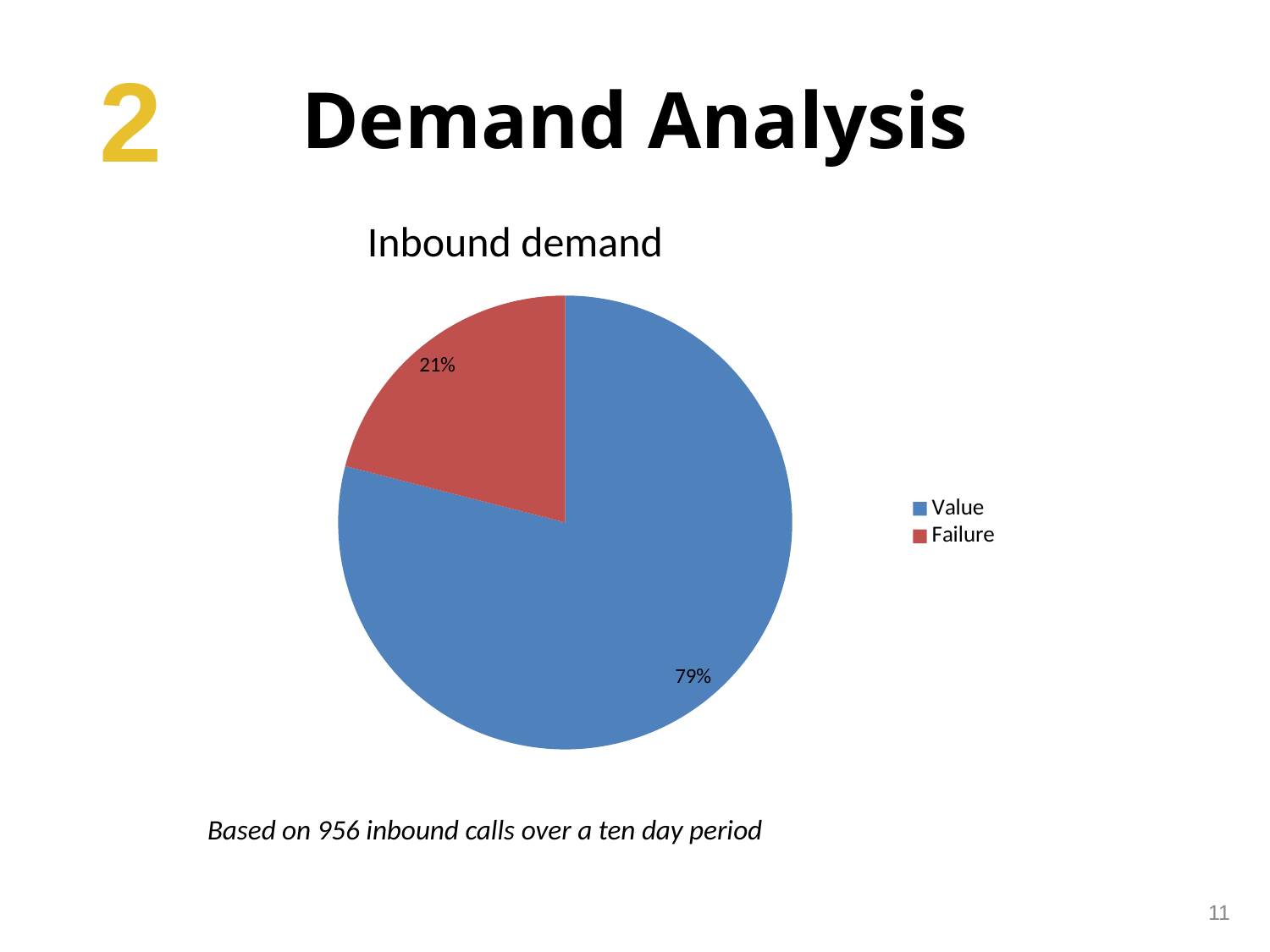
What share of inbound demand is labelled Failure? 21% Which is larger, the Value slice or the Failure slice? Value What is the difference in percentage points between the Value and Failure slices? 58 Which slice is the smallest? Failure What kind of chart is shown on the slide? pie chart Is the share for Failure greater or less than 25%? less Which slice is the largest? Value What share of inbound demand is labelled Value? 79% What colour is the Failure slice? red How many slices does the pie chart have? 2 How many entries does the legend list? 2 What is the chart's title? Inbound demand